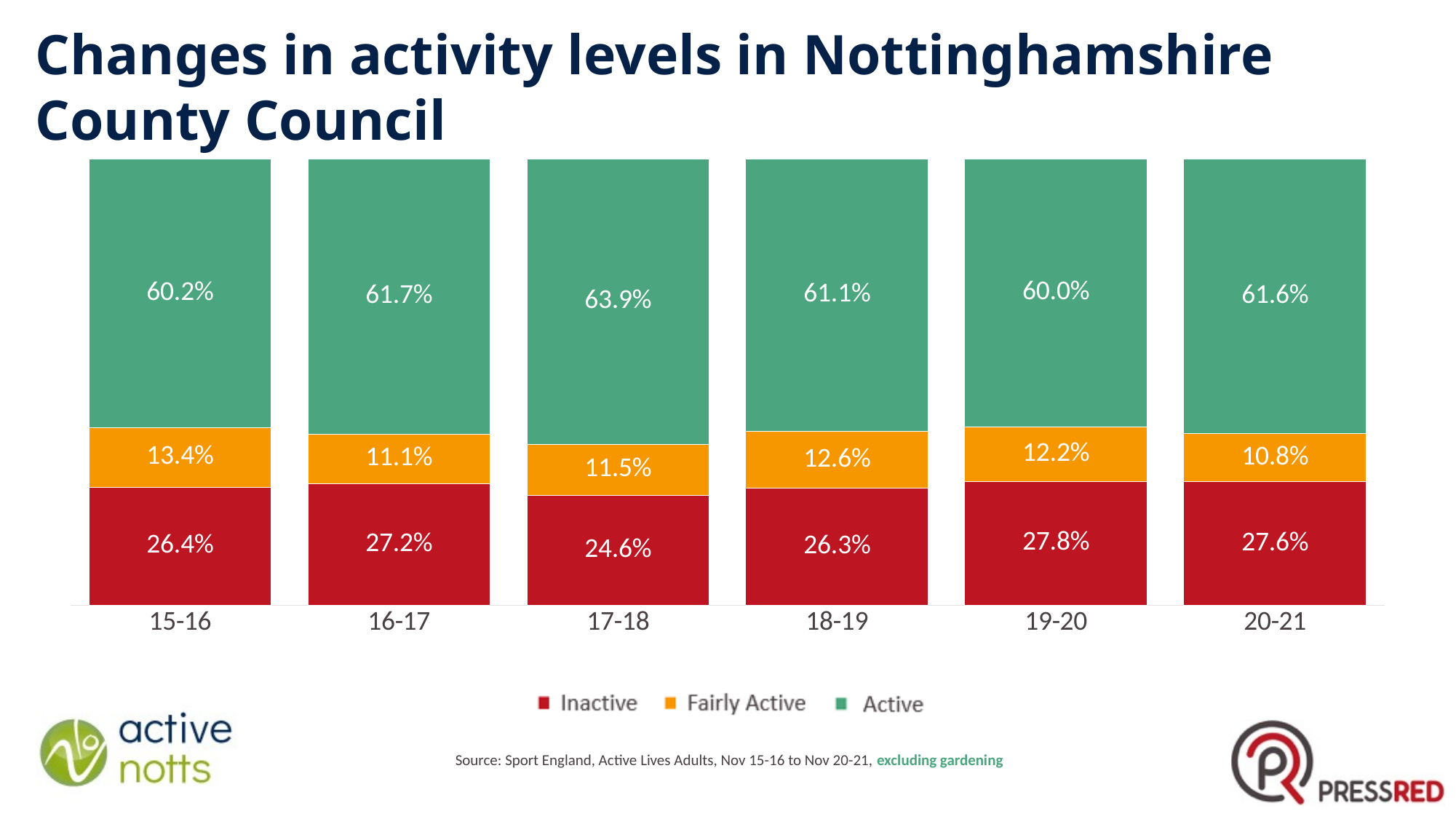
Which year has the lowest Fairly Active percentage? 20-21 What is the difference between the Inactive percentages for 19-20 and 17-18? 3.2% What kind of chart is shown on the slide? Stacked bar chart Which colour represents the Inactive series? Red How many series does the legend list? 3 Which year has the lowest Inactive percentage? 17-18 What is the Inactive percentage for 19-20? 27.8% What is the Active percentage for 17-18? 63.9% Which year has the highest Active percentage? 17-18 Is the Active percentage higher in 16-17 or in 19-20? 16-17 How many years are shown on the x axis? 6 What is the Fairly Active percentage for 20-21? 10.8%